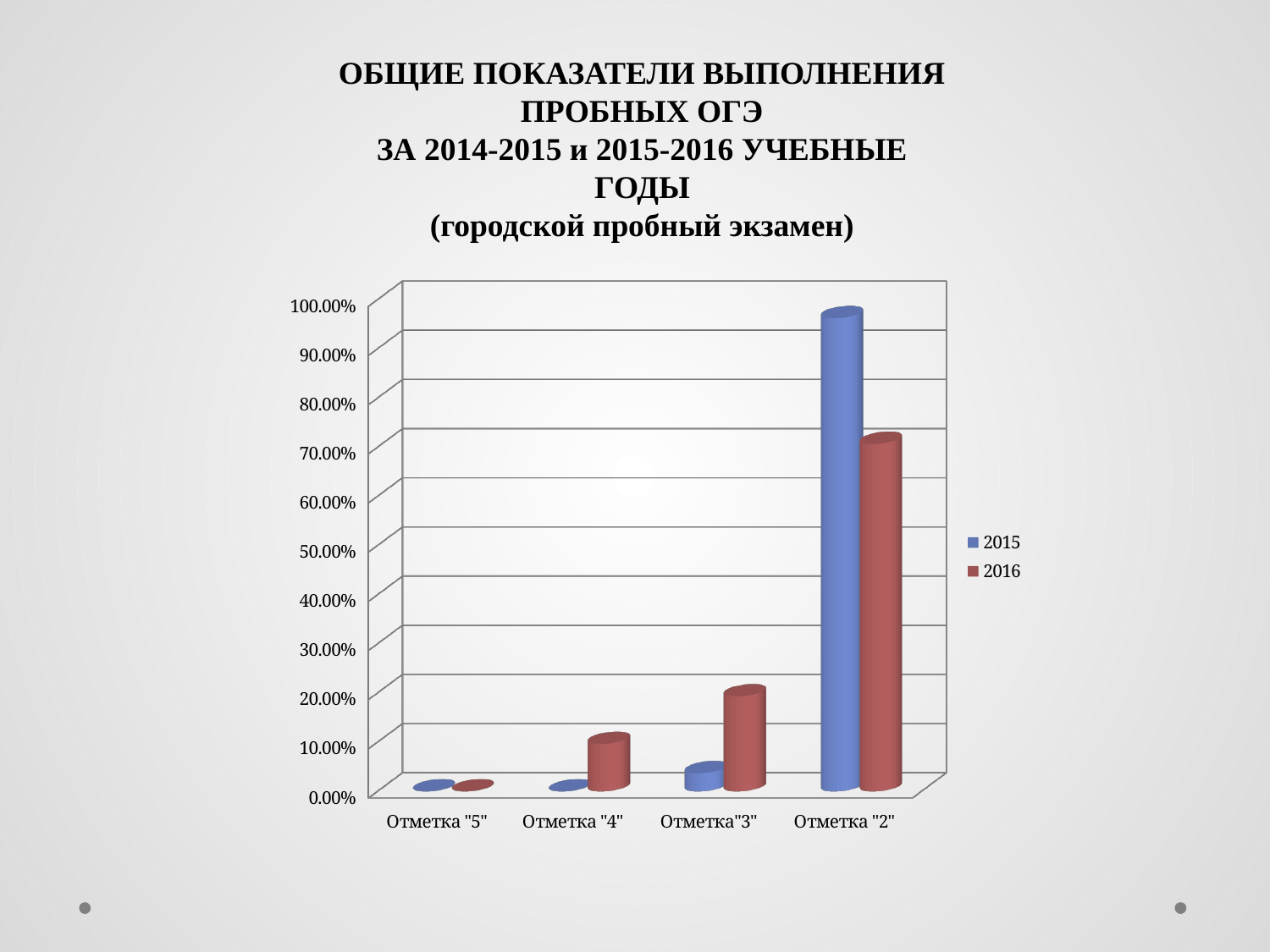
Is the 2015 value for Отметка "2" greater or less than 90.00%? greater How many categories are shown on the x axis? 4 Is the 2016 value for Отметка "2" greater or less than 80.00%? less Which category has the highest value for the 2015 series? Отметка "2" For Отметка"3", which series has the larger value, 2015 or 2016? 2016 Which category has the highest value for the 2016 series? Отметка "2" Is the 2016 value for Отметка"3" greater or less than 30.00%? less For Отметка "2", which series has the larger value, 2015 or 2016? 2015 Do the 2016 values rise or fall moving along the x axis from Отметка "5" to Отметка "2"? rise How many series does the legend list? 2 What kind of chart is shown on the slide? bar chart Which category has the lowest value for the 2016 series? Отметка "5"